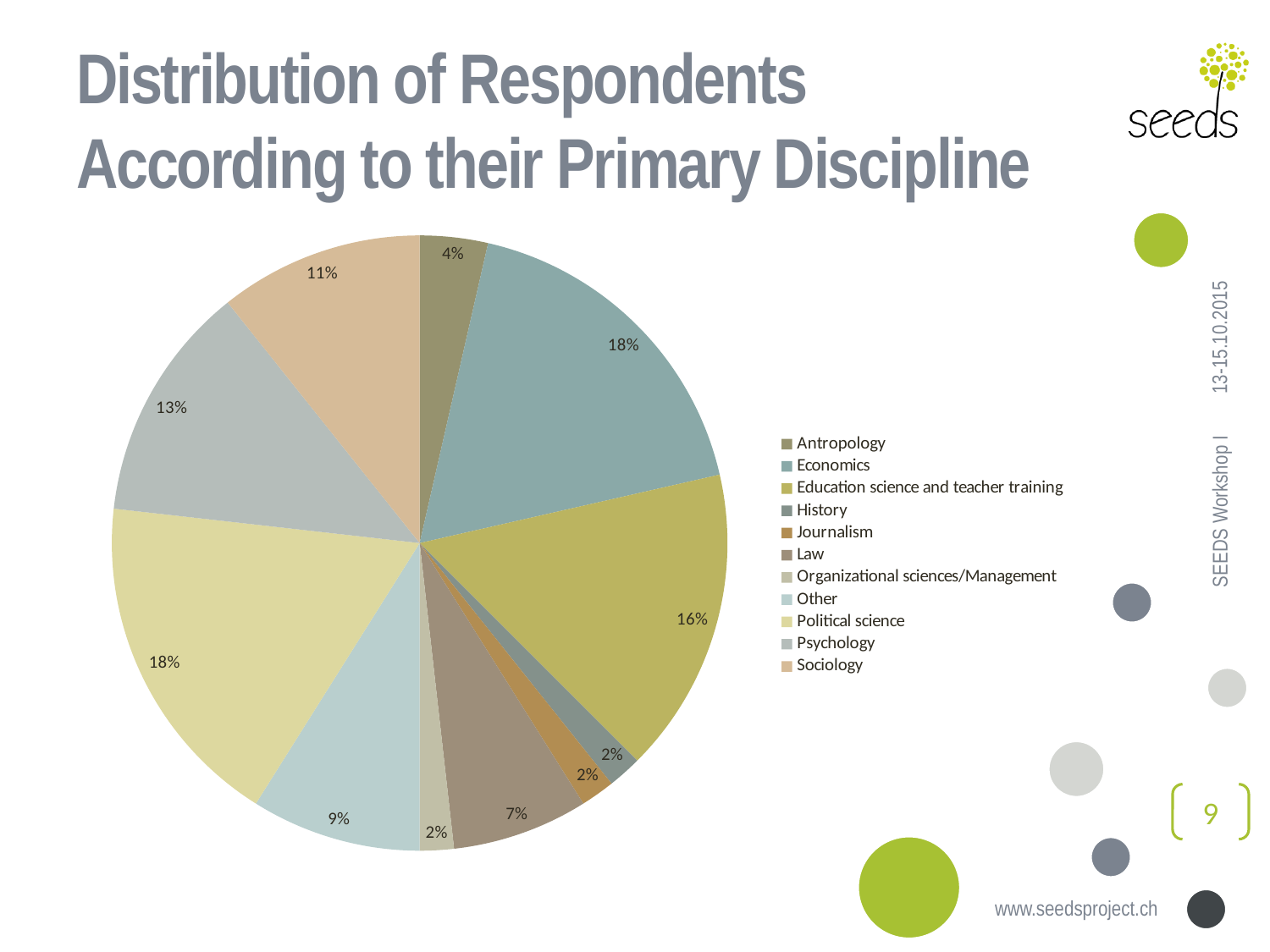
How many disciplines does the legend list? 11 What percentage is shown for Antropology? 4% What percentage is shown for Education science and teacher training? 16% Which is larger, the share for Psychology or the share for Sociology? Psychology What percentage of respondents have Economics as their primary discipline? 18% What is the title of the chart on the slide? Distribution of Respondents According to their Primary Discipline What percentage of respondents are in Law? 7% What percentage is shown for Sociology? 11% What share of the pie is Psychology? 13% What is the difference between the Economics share and the Education science and teacher training share? 2% What kind of chart is shown on the slide? pie chart What percentage of respondents fall under Other? 9%